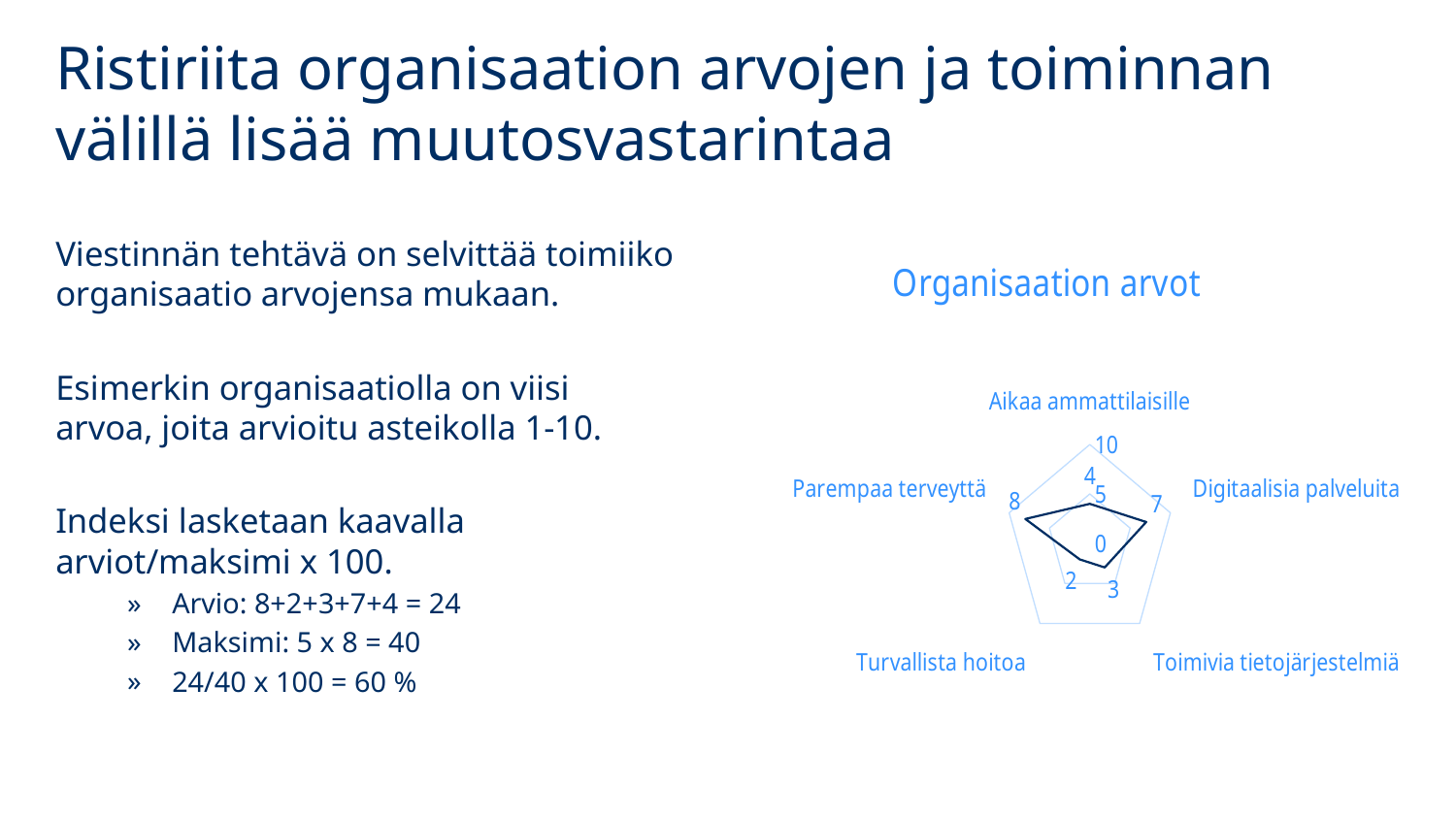
What is the value for Turvallista hoitoa in the Organisaation arvot chart? 2 Is the value for Digitaalisia palveluita in the Organisaation arvot chart greater or less than 5? greater What is the value for Parempaa terveyttä in the Organisaation arvot chart? 8 What is the value for Aikaa ammattilaisille in the Organisaation arvot chart? 4 What is the value for Toimivia tietojärjestelmiä in the Organisaation arvot chart? 3 What is the value for Digitaalisia palveluita in the Organisaation arvot chart? 7 How many categories are plotted in the Organisaation arvot chart? 5 Which category has the highest value in the Organisaation arvot chart? Parempaa terveyttä Which has a larger value in the Organisaation arvot chart, Digitaalisia palveluita or Aikaa ammattilaisille? Digitaalisia palveluita What is the difference between the values for Parempaa terveyttä and Turvallista hoitoa in the Organisaation arvot chart? 6 Which category has the lowest value in the Organisaation arvot chart? Turvallista hoitoa What kind of chart is the Organisaation arvot chart? Radar chart